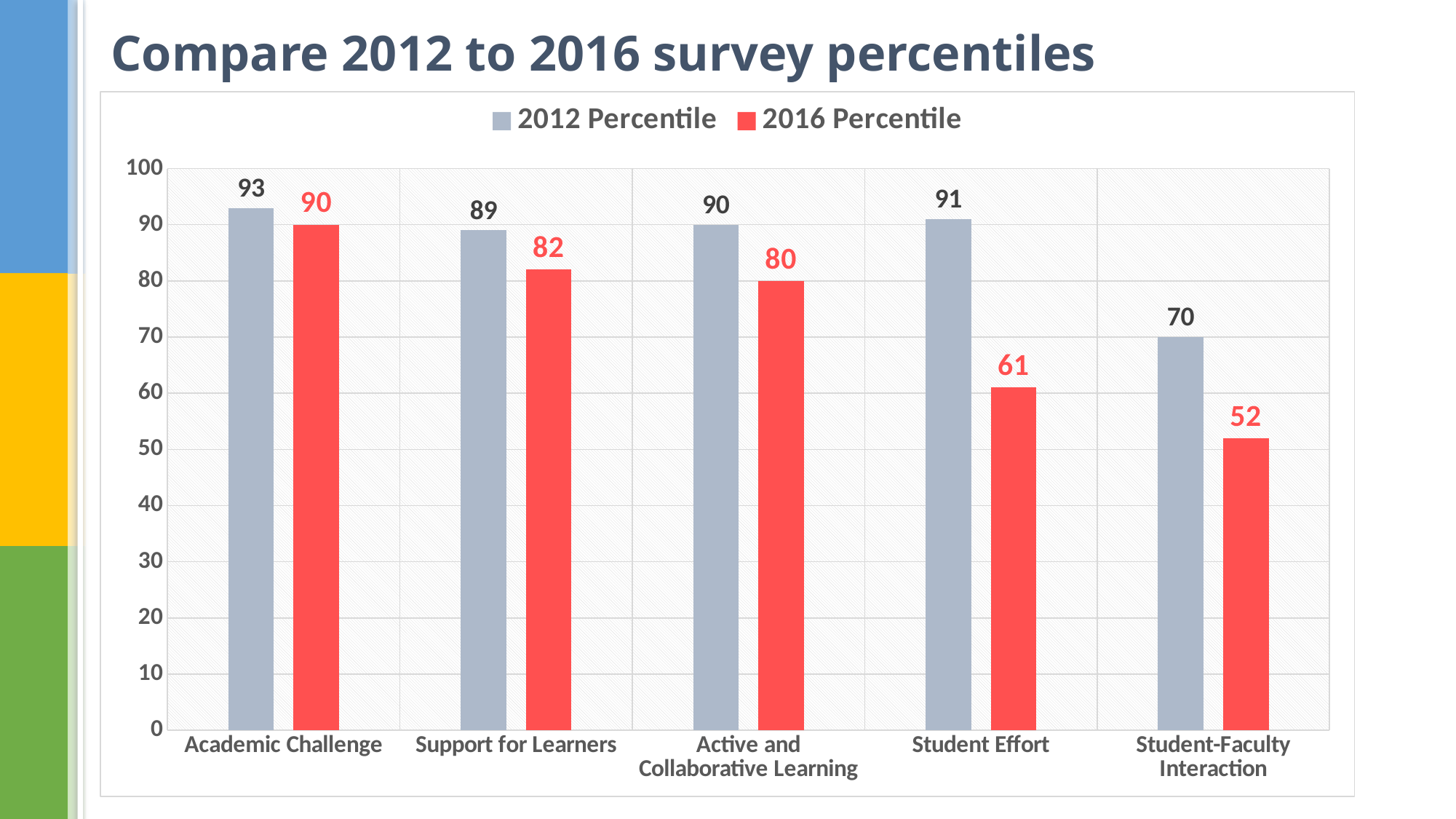
What is the 2016 Percentile for Student-Faculty Interaction? 52 What kind of chart is shown on the slide? Bar chart Which is larger for Support for Learners: the 2012 Percentile or the 2016 Percentile? 2012 Percentile What is the 2016 Percentile for Active and Collaborative Learning? 80 What is the 2012 Percentile for Academic Challenge? 93 What colour are the 2016 Percentile bars? Red How many series does the legend list? 2 Does the 2016 Percentile rise or fall from Academic Challenge to Student-Faculty Interaction? Fall Which category has the highest 2012 Percentile? Academic Challenge What is the difference between the 2012 Percentile and the 2016 Percentile for Student Effort? 30 How many categories are shown on the x axis? 5 Which category has the lowest 2016 Percentile? Student-Faculty Interaction